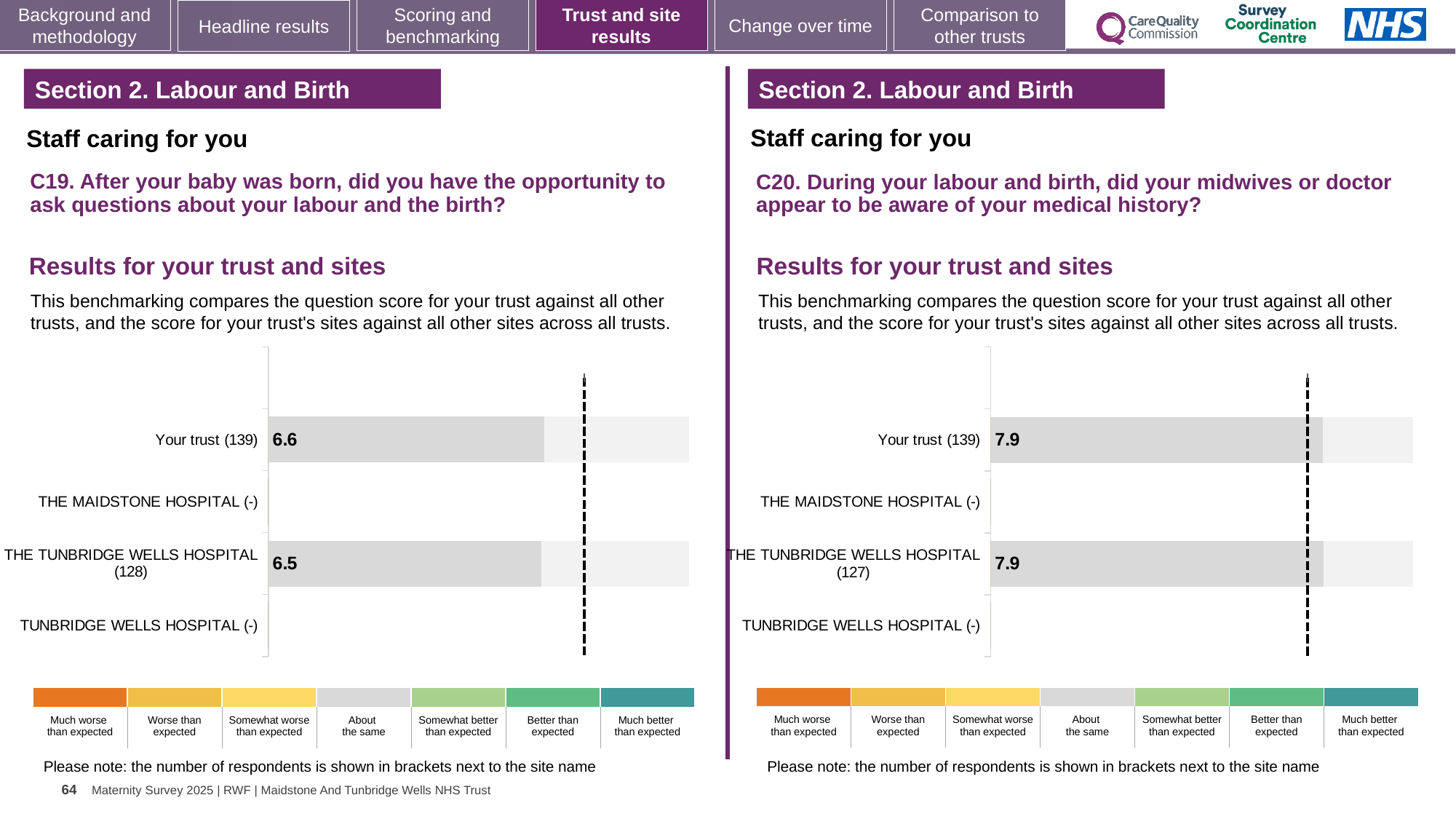
In the C19 chart on the left, what is the score for THE TUNBRIDGE WELLS HOSPITAL (128)? 6.5 In the C19 chart on the left, which has the higher score: Your trust (139) or THE TUNBRIDGE WELLS HOSPITAL (128)? Your trust (139) In the C19 chart on the left, what is the difference between the score for Your trust (139) and the score for THE TUNBRIDGE WELLS HOSPITAL (128)? 0.1 In the C20 chart on the right, what is the score for THE TUNBRIDGE WELLS HOSPITAL (127)? 7.9 In the colour key below the C19 chart on the left, which category is shown in orange at the far left? Much worse than expected In the C20 chart on the right, how many respondents are shown in brackets for THE TUNBRIDGE WELLS HOSPITAL? 127 In the C20 chart on the right, what is the score for Your trust (139)? 7.9 In the C19 chart on the left, how many respondents are shown in brackets for THE TUNBRIDGE WELLS HOSPITAL? 128 In the C20 chart on the right, what is the difference between the score for Your trust (139) and the score for THE TUNBRIDGE WELLS HOSPITAL (127)? 0 How many site/trust categories are listed on the y axis of the C19 chart on the left? 4 What kind of chart is the C20 chart on the right? Bar chart In the C19 chart on the left, what is the score for Your trust (139)? 6.6